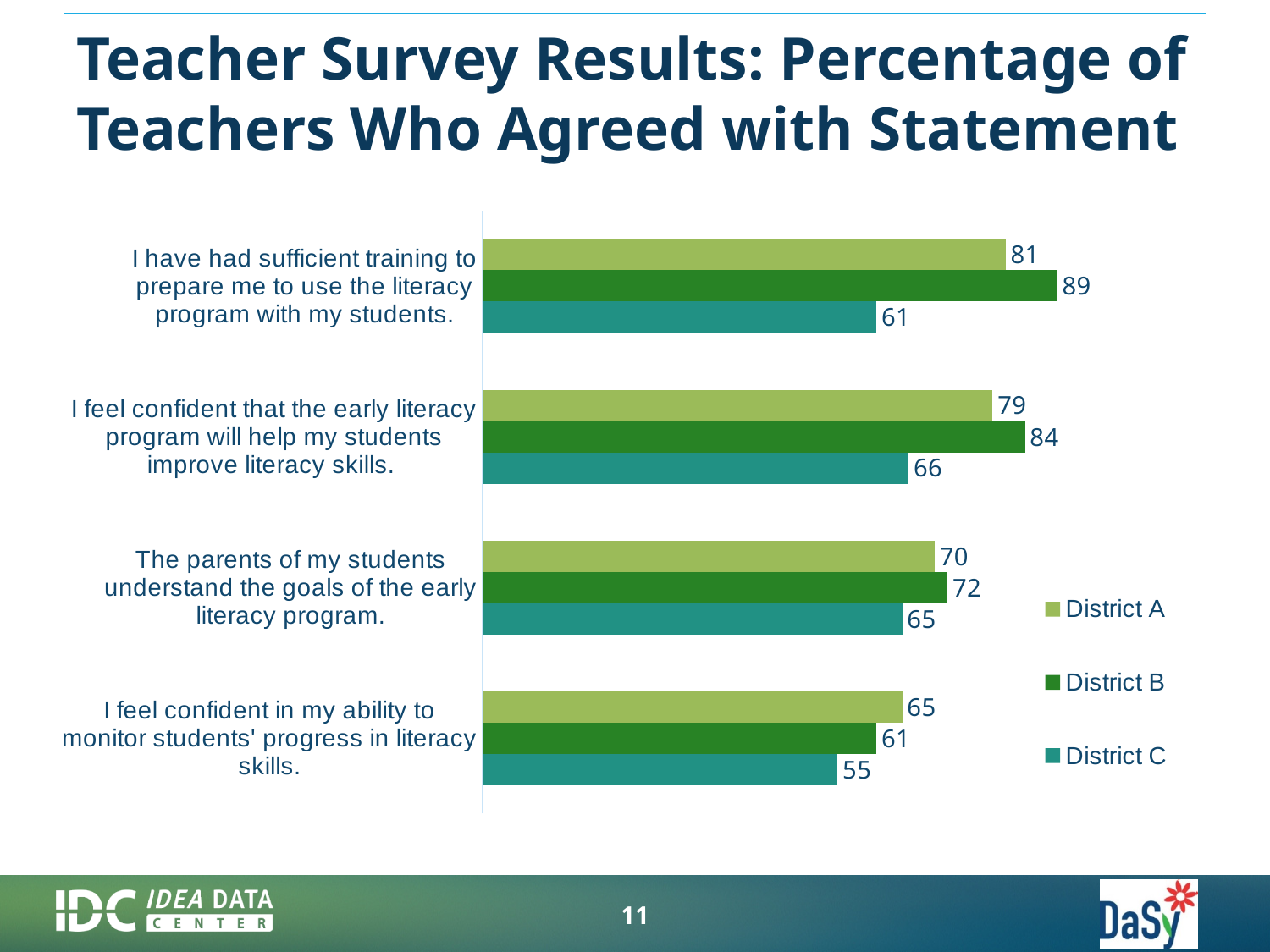
Which district is represented by the darkest green bars in the legend? District B How many survey statements are shown on the chart? 4 What kind of chart is shown on the slide? Bar chart What is the difference between District B and District C for the statement "I have had sufficient training to prepare me to use the literacy program with my students"? 28 For the statement "I feel confident in my ability to monitor students' progress in literacy skills", which is larger: District A or District B? District A How many series does the legend list? 3 Which district has the lowest value for the statement "I have had sufficient training to prepare me to use the literacy program with my students"? District C What percentage of District B teachers agreed with the statement "I have had sufficient training to prepare me to use the literacy program with my students"? 89 What is the difference between District A and District B for the statement "I feel confident in my ability to monitor students' progress in literacy skills"? 4 What is the value for District A on the statement "The parents of my students understand the goals of the early literacy program"? 70 What is the value for District C on the statement "I feel confident in my ability to monitor students' progress in literacy skills"? 55 Which district has the highest value for the statement "I feel confident that the early literacy program will help my students improve literacy skills"? District B